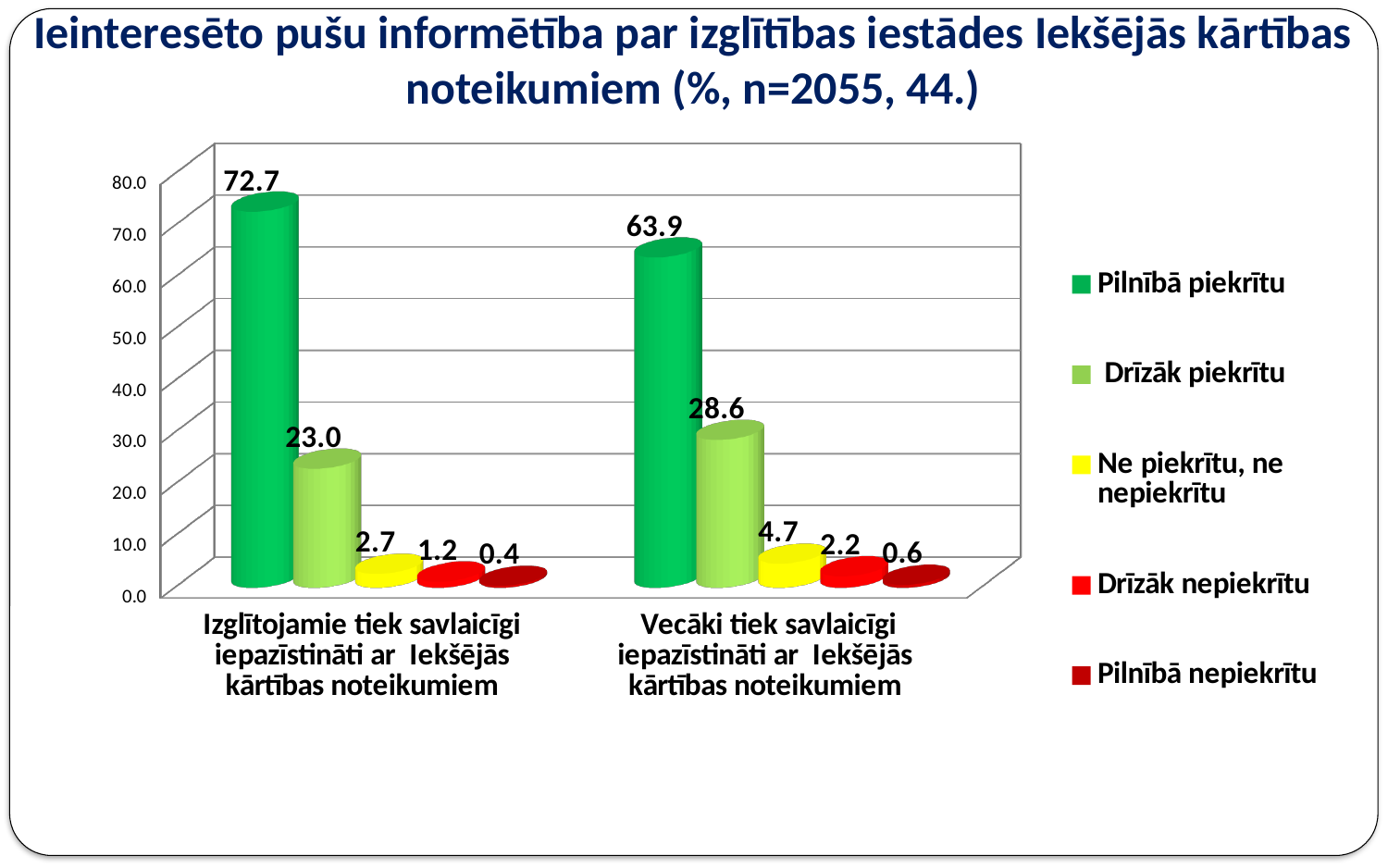
What is the value for "Drīzāk piekrītu" in the category "Vecāki tiek savlaicīgi iepazīstināti ar Iekšējās kārtības noteikumiem"? 28.6 Is the value for "Pilnībā piekrītu" in the category "Vecāki tiek savlaicīgi iepazīstināti ar Iekšējās kārtības noteikumiem" greater or less than 60.0? greater Which series has the highest value in the category "Vecāki tiek savlaicīgi iepazīstināti ar Iekšējās kārtības noteikumiem"? Pilnībā piekrītu What is the difference between the "Pilnībā piekrītu" values for the two categories? 8.8 Which category has the larger value for "Drīzāk nepiekrītu"? Vecāki tiek savlaicīgi iepazīstināti ar Iekšējās kārtības noteikumiem How many categories are shown on the x axis? 2 How many series does the legend list? 5 What kind of chart is shown on the slide? Bar chart What is the value for "Pilnībā nepiekrītu" in the category "Izglītojamie tiek savlaicīgi iepazīstināti ar Iekšējās kārtības noteikumiem"? 0.4 What is the value for "Pilnībā piekrītu" in the category "Izglītojamie tiek savlaicīgi iepazīstināti ar Iekšējās kārtības noteikumiem"? 72.7 Which series has the lowest value in the category "Izglītojamie tiek savlaicīgi iepazīstināti ar Iekšējās kārtības noteikumiem"? Pilnībā nepiekrītu What is the value for "Ne piekrītu, ne nepiekrītu" in the category "Vecāki tiek savlaicīgi iepazīstināti ar Iekšējās kārtības noteikumiem"? 4.7